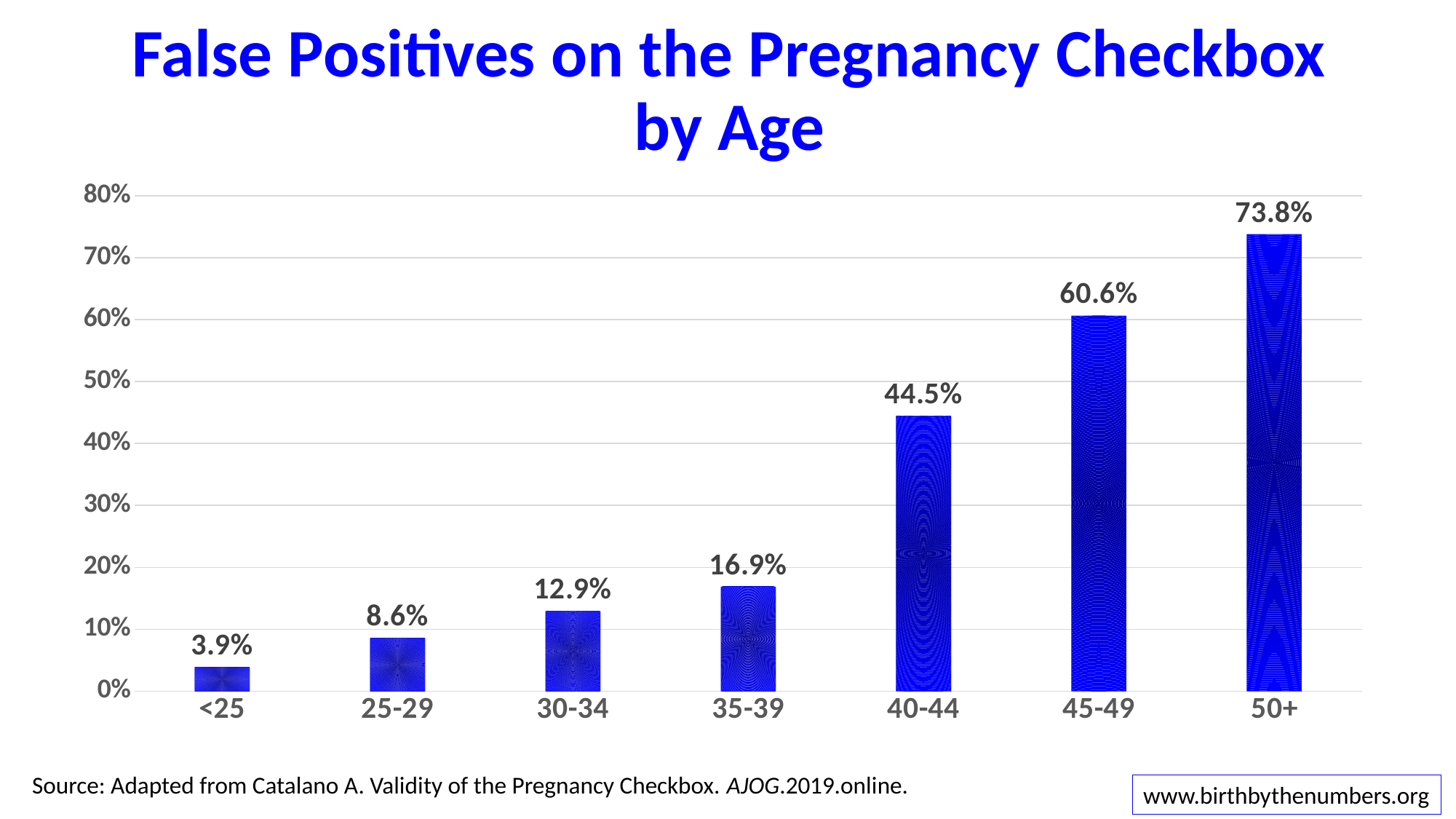
Which age group has the highest false positive rate? 50+ Which age group has the lowest false positive rate? <25 What is the difference in false positive rate between the 35-39 and 25-29 age groups? 8.3% What is the difference in false positive rate between the 50+ and 45-49 age groups? 13.2% What is the false positive rate for the 40-44 age group? 44.5% What kind of chart is shown on the slide? Bar chart Do the false positive rates rise or fall as age increases along the x axis? Rise What is the false positive rate for the 30-34 age group? 12.9% What is the false positive rate for the <25 age group? 3.9% How many age groups are shown on the chart? 7 Which age group has a higher false positive rate, 40-44 or 35-39? 40-44 Is the value for the 45-49 age group greater or less than 50%? greater